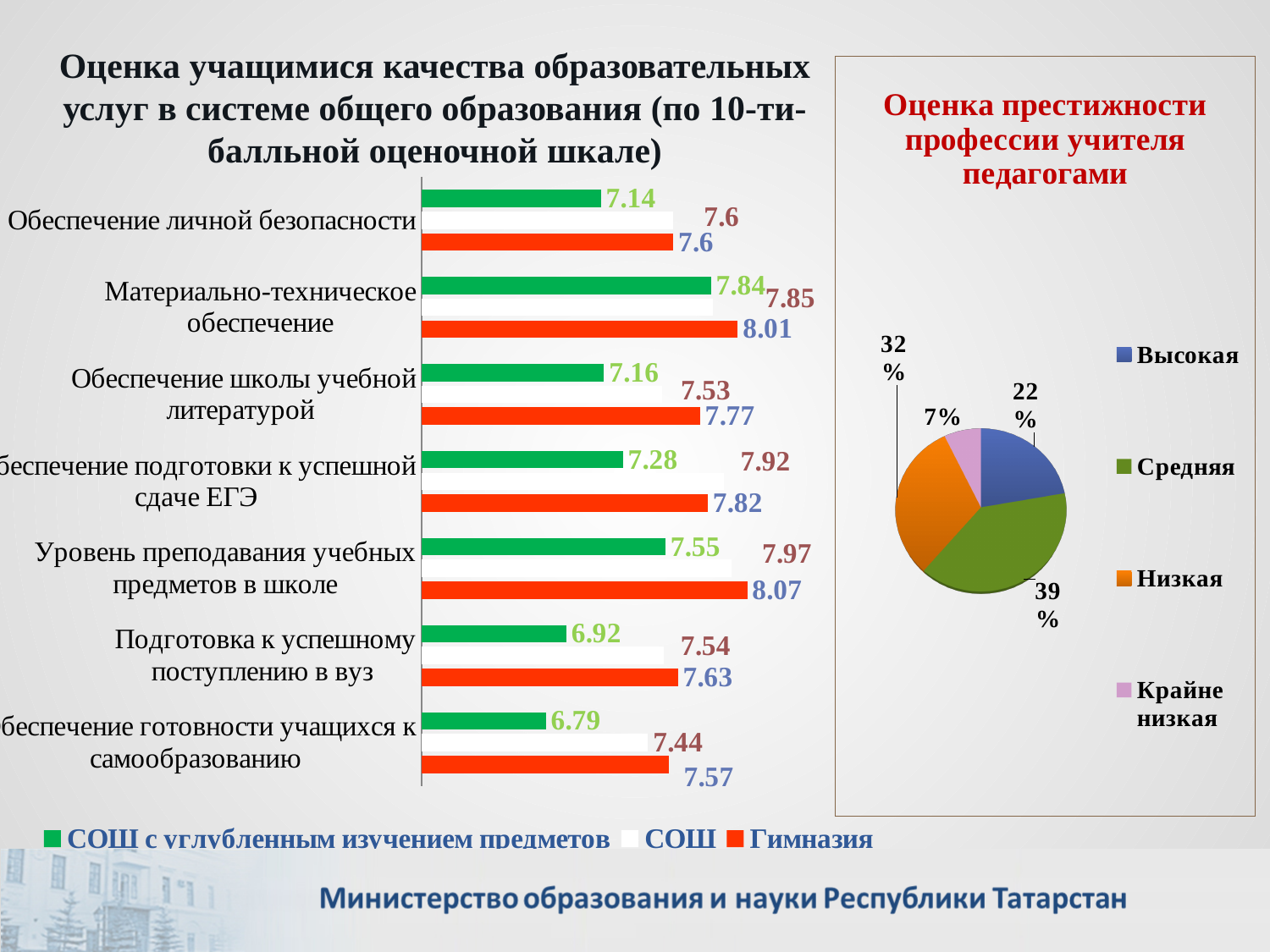
In the bar chart on the left, what is the difference between the Гимназия and СОШ с углубленным изучением предметов values for Обеспечение школы учебной литературой? 0.61 What type of chart is the chart titled 'Оценка престижности профессии учителя педагогами'? Pie chart In the pie chart 'Оценка престижности профессии учителя педагогами', which category has the smallest share? Крайне низкая In the bar chart on the left, what is the value for Гимназия for Уровень преподавания учебных предметов в школе? 8.07 In the bar chart on the left, which category has the lowest value for СОШ с углубленным изучением предметов? Обеспечение готовности учащихся к самообразованию In the pie chart 'Оценка престижности профессии учителя педагогами', what is the difference between the shares of Низкая and Высокая? 10% In the pie chart 'Оценка престижности профессии учителя педагогами', what share is Средняя? 39% How many series does the legend of the bar chart on the left list? 3 In the bar chart on the left, for Обеспечение личной безопасности, which is larger: the value for СОШ or for СОШ с углубленным изучением предметов? СОШ In the bar chart on the left, what is the value for СОШ for Материально-техническое обеспечение? 7.85 In the bar chart on the left, what is the value for СОШ с углубленным изучением предметов for Подготовка к успешному поступлению в вуз? 6.92 In the bar chart on the left, which category has the highest value for Гимназия? Уровень преподавания учебных предметов в школе